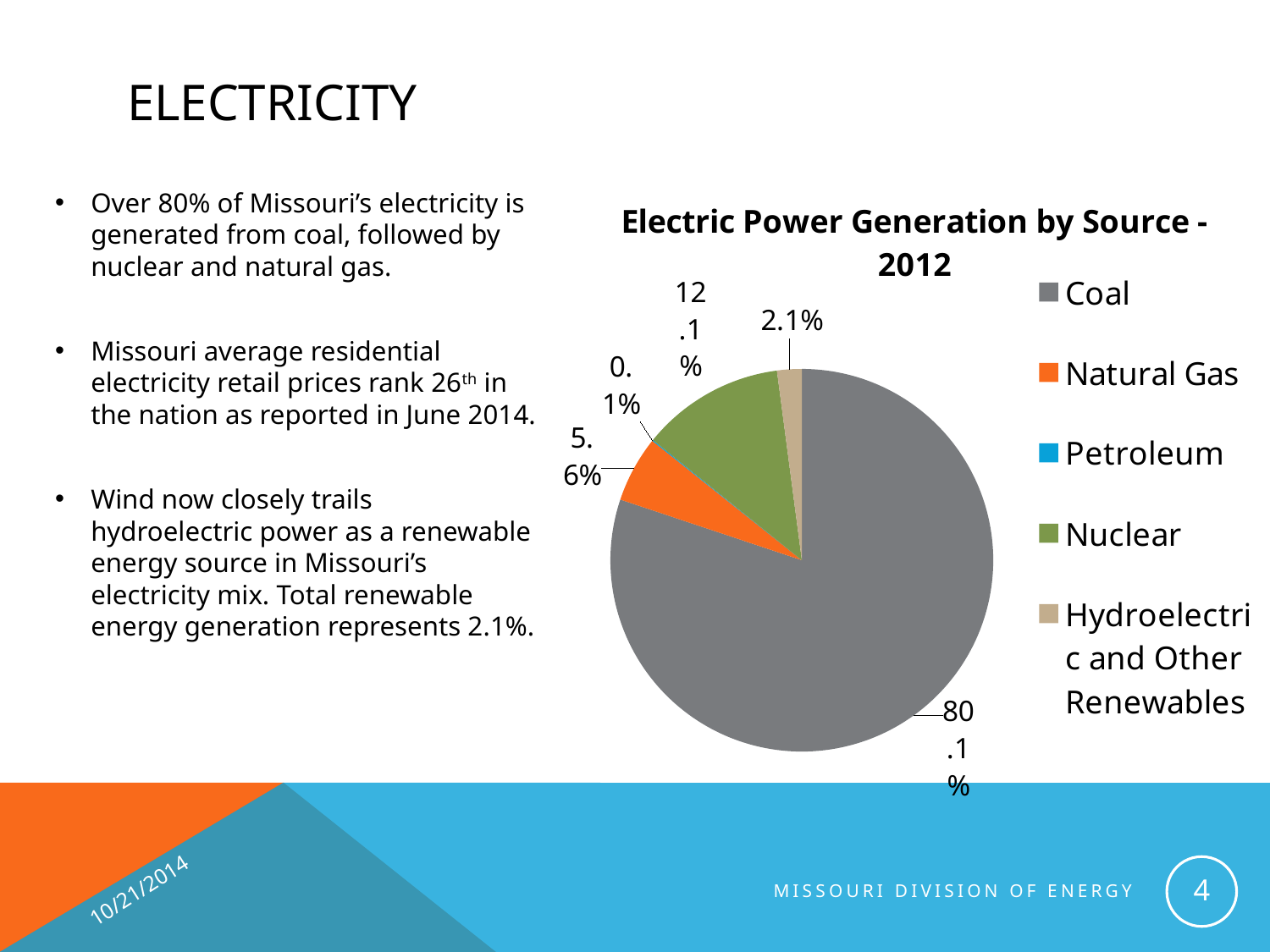
How many sources does the legend list? 5 What share of electric power generation comes from Coal? 80.1% What share of electric power generation comes from Petroleum? 0.1% How many percentage points larger is the Coal share than the Nuclear share? 68 percentage points Which has a larger share, Nuclear or Natural Gas? Nuclear Which source has the largest share of electric power generation? Coal What share of electric power generation comes from Nuclear? 12.1% What is the title of the chart? Electric Power Generation by Source - 2012 What share of electric power generation comes from Hydroelectric and Other Renewables? 2.1% What share of electric power generation comes from Natural Gas? 5.6% What type of chart is shown on the slide? pie chart Which source has the smallest share of electric power generation? Petroleum